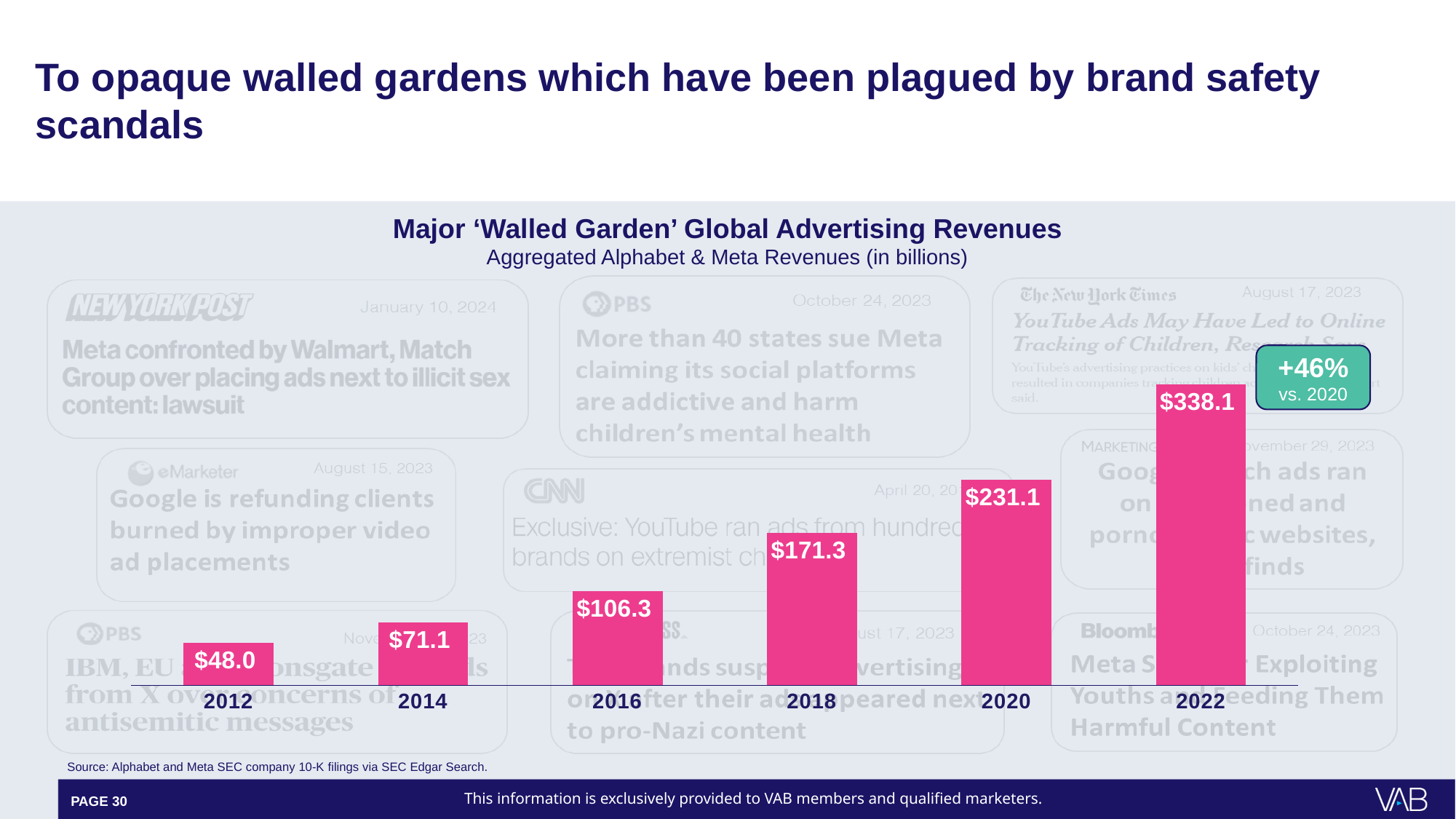
What is the value for 2018? $171.3 Which is larger, the value for 2016 or the value for 2018? 2018 What percentage change versus 2020 is shown in the callout next to the 2022 bar? +46% What is the value for 2012? $48.0 What is the value for 2022? $338.1 What is the difference between the values for 2016 and 2014? $35.2 Do the values rise or fall from 2012 to 2022? rise What kind of chart is this? bar chart What is the difference between the values for 2022 and 2020? $107.0 Which year has the lowest value? 2012 How many years are shown on the chart? 6 Which year has the highest value? 2022